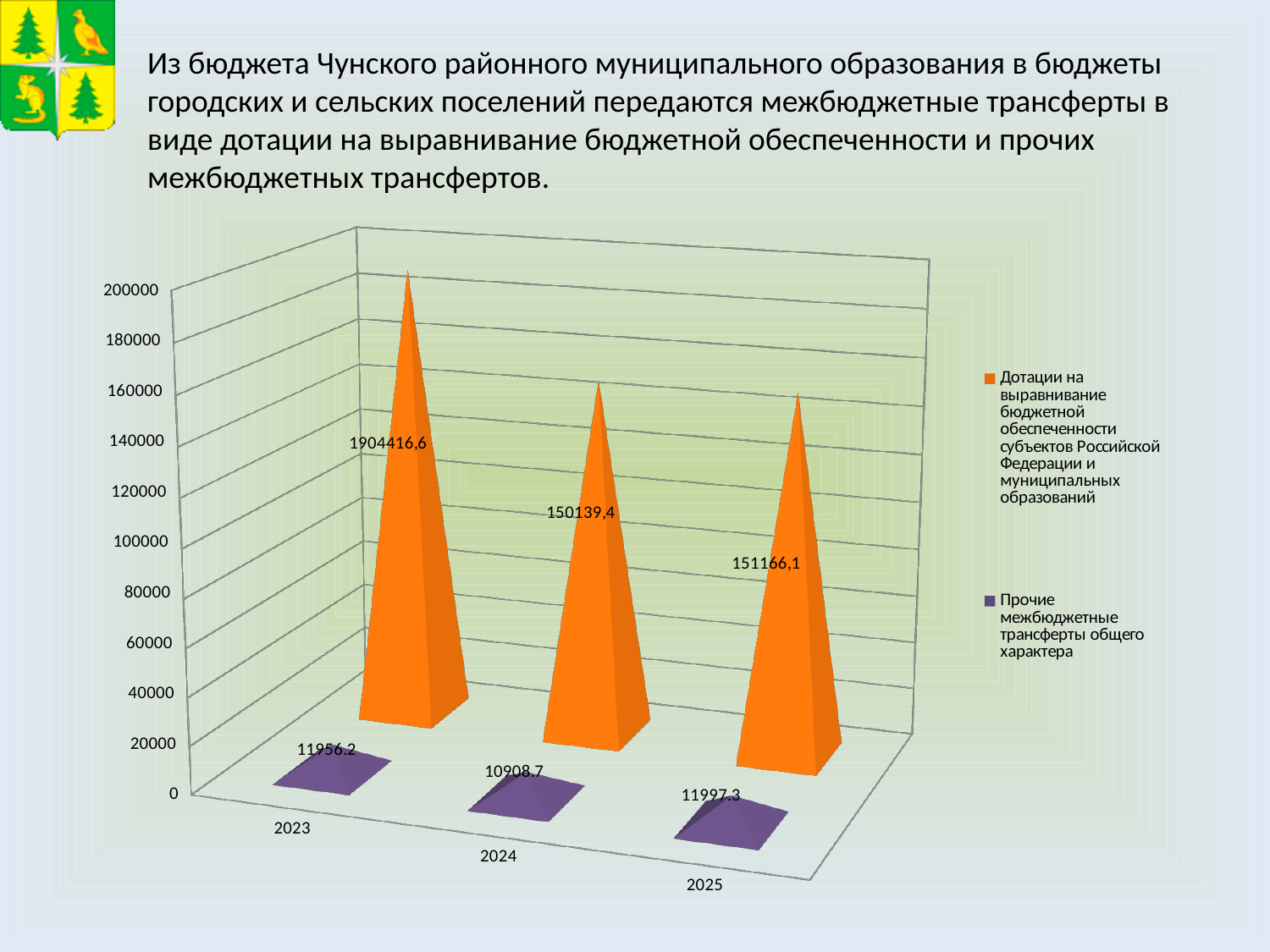
What is the value of Прочие межбюджетные трансферты общего характера for 2025? 11997.3 What is the value of Прочие межбюджетные трансферты общего характера for 2023? 11956.2 What is the value of Дотации на выравнивание бюджетной обеспеченности for 2024? 150139,4 What is the value of Дотации на выравнивание бюджетной обеспеченности for 2025? 151166,1 In which year is the value of Дотации на выравнивание бюджетной обеспеченности highest? 2023 What is the value of Прочие межбюджетные трансферты общего характера for 2024? 10908.7 What is the difference between the Прочие межбюджетные трансферты values for 2025 and 2023? 41.1 How many years are shown on the x axis of the chart? 3 In which year is the value of Прочие межбюджетные трансферты общего характера lowest? 2024 How many series does the chart legend list? 2 Is the value of Прочие межбюджетные трансферты общего характера for 2023 greater or less than 20000? less What is the value of Дотации на выравнивание бюджетной обеспеченности for 2023? 1904416,6